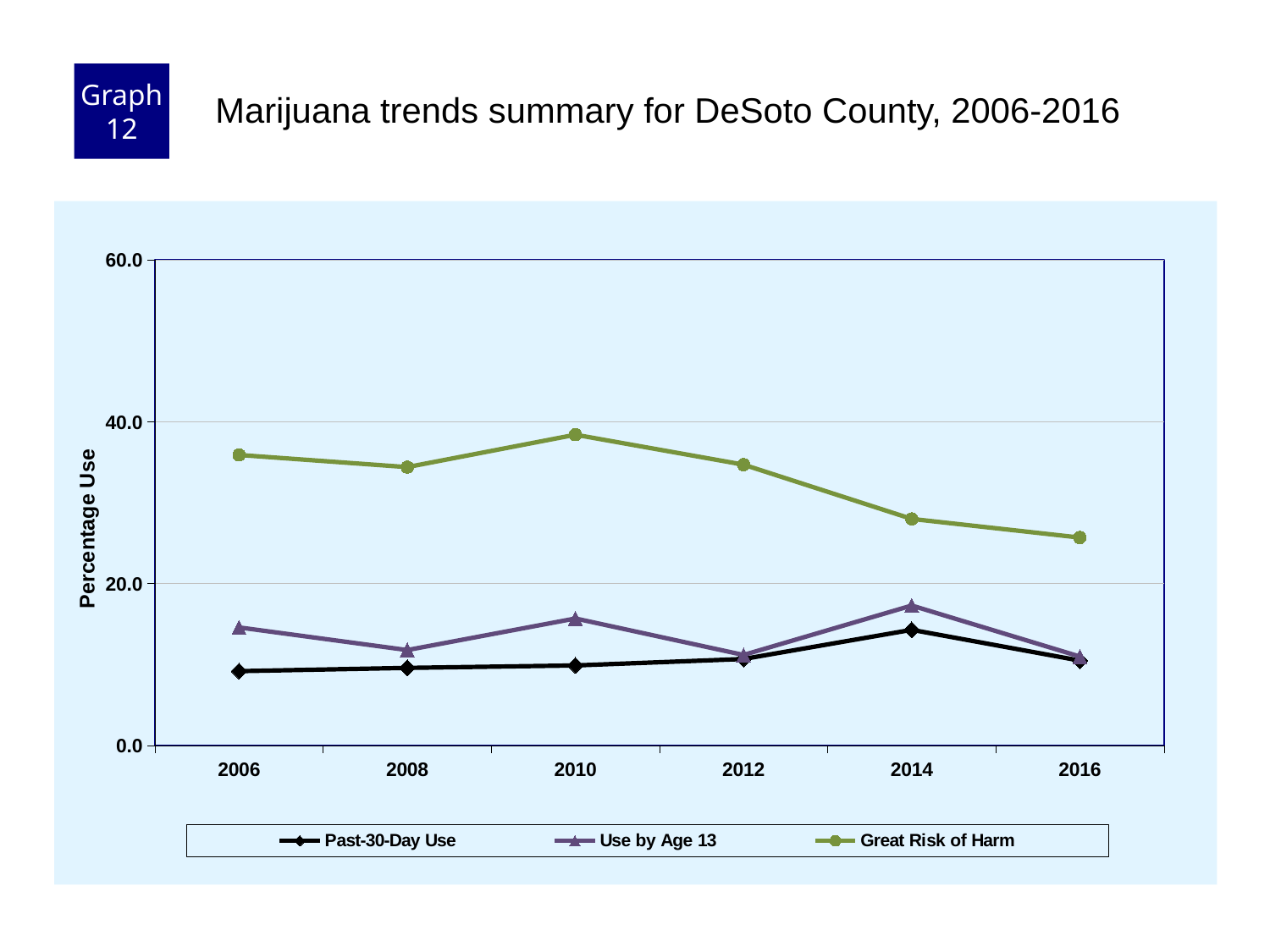
In which year is the Great Risk of Harm series at its highest? 2010 How many years are plotted along the x axis? 6 Does the Great Risk of Harm series rise or fall from 2010 to 2016? Fall In which year is the Great Risk of Harm series at its lowest? 2016 In 2006, which series has the larger value: Use by Age 13 or Past-30-Day Use? Use by Age 13 How many series does the legend list? 3 In which year is the Past-30-Day Use series at its highest? 2014 What kind of chart is shown on the slide? Line chart Is the value for Great Risk of Harm in 2010 greater or less than 40.0? less What is the label on the y axis? Percentage Use Is the value for Great Risk of Harm in 2016 greater or less than 20.0? greater Is the value for Past-30-Day Use in 2006 greater or less than 20.0? less